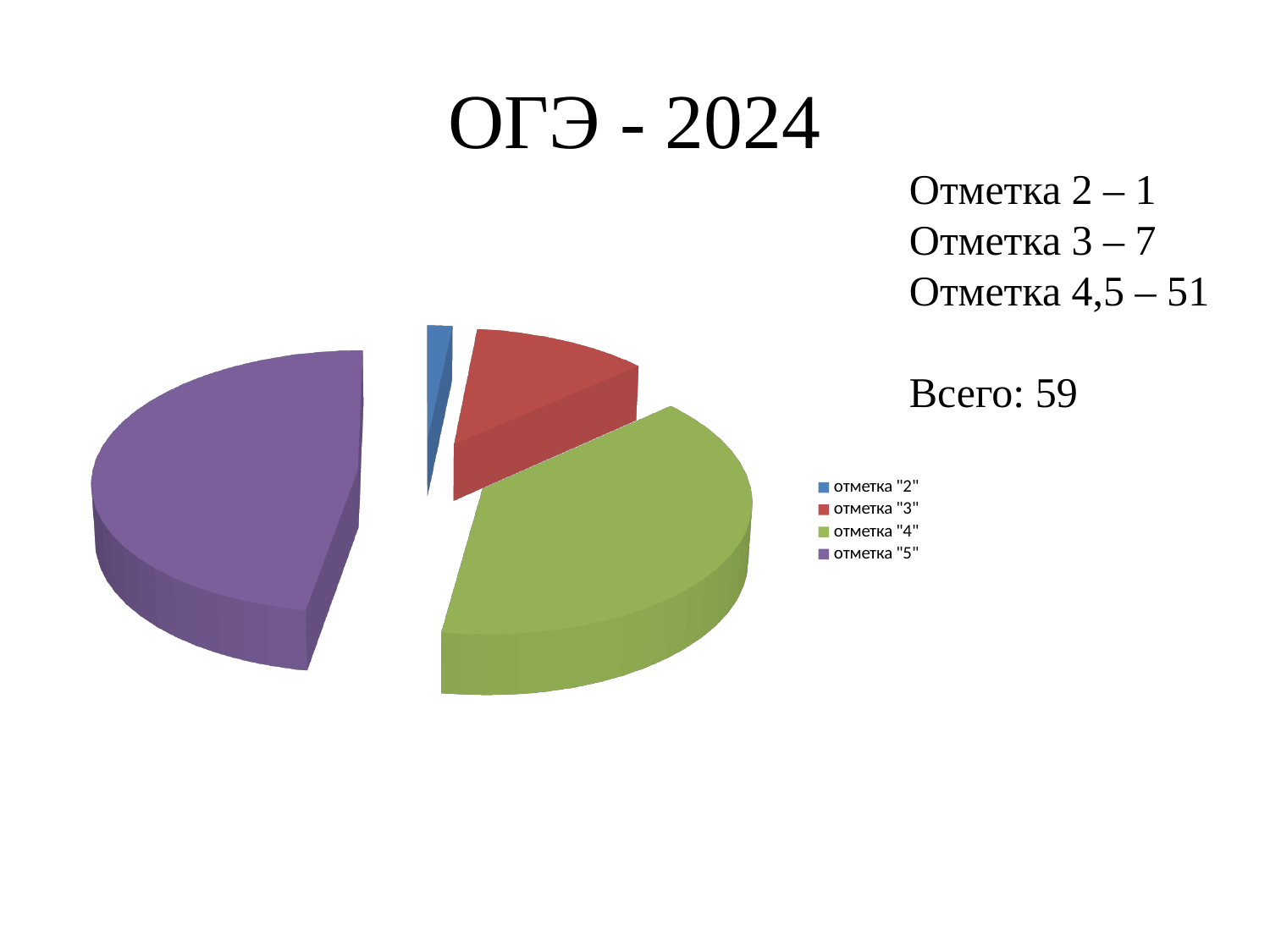
Which slice is larger, отметка "3" or отметка "2"? отметка "3" What total number of students (Всего) is stated on the slide? 59 How many entries does the legend of the pie chart list? 4 What colour is the slice for отметка "5" in the pie chart? purple Which slice is larger, отметка "4" or отметка "3"? отметка "4" According to the text on the slide, how many students received отметка 3? 7 What kind of chart is shown on the slide? pie chart What is the title of the slide containing the pie chart? ОГЭ - 2024 Which slice of the pie chart is the smallest? отметка "2" According to the text on the slide, how many students received отметка 2? 1 How many slices does the pie chart have? 4 Which slice is larger, отметка "5" or отметка "3"? отметка "5"